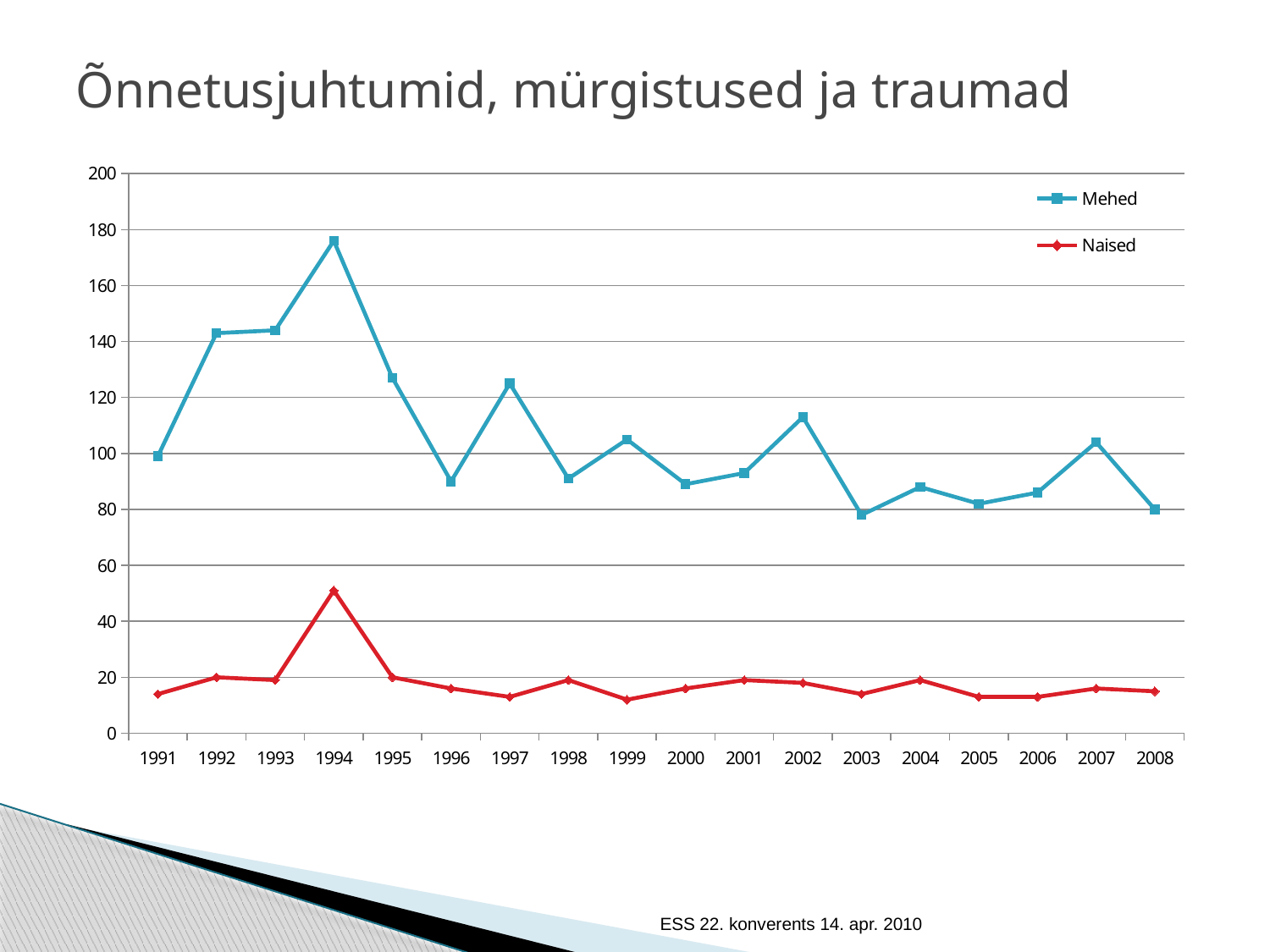
In which year does the Mehed series reach its highest value? 1994 What is the title of the chart? Õnnetusjuhtumid, mürgistused ja traumad Is the value for Mehed in 1994 greater or less than 160? greater Does the Mehed series rise or fall from 1994 to 1996? fall Which is larger for Mehed: the value in 1997 or the value in 1998? 1997 How many years are plotted along the x axis? 18 Is the value for Mehed in 1996 greater or less than 100? less Is the value for Naised in 1994 greater or less than 40? greater How many series does the legend list? 2 What kind of chart is shown on the slide? line chart In which year does the Naised series reach its highest value? 1994